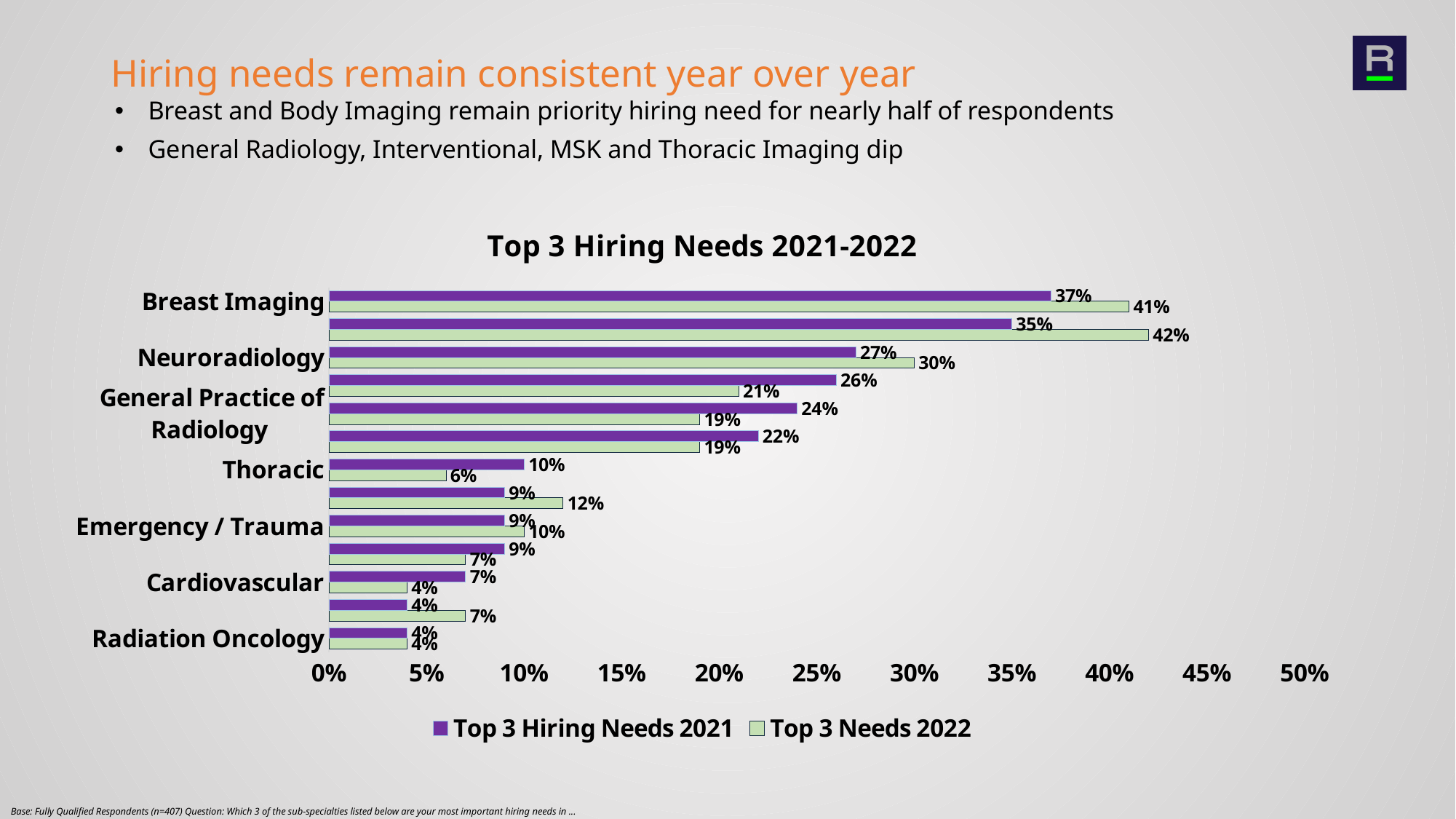
Is the value for Neuroradiology in the Top 3 Needs 2022 series greater or less than 25%? greater How many series does the legend list? 2 What is the value for Thoracic in the Top 3 Needs 2022 series? 6% What is the difference between the 2021 and 2022 values for General Practice of Radiology? 5 percentage points What kind of chart is shown on the slide? Bar chart What is the value for Cardiovascular in the Top 3 Needs 2022 series? 4% What is the difference between the 2022 and 2021 values for Breast Imaging? 4 percentage points For Neuroradiology, which series has the larger value: Top 3 Hiring Needs 2021 or Top 3 Needs 2022? Top 3 Needs 2022 What is the value for General Practice of Radiology in the Top 3 Hiring Needs 2021 series? 24% What is the value for Neuroradiology in the Top 3 Needs 2022 series? 30% Which category has the highest value in the Top 3 Hiring Needs 2021 series? Breast Imaging What is the value for Breast Imaging in the Top 3 Hiring Needs 2021 series? 37%